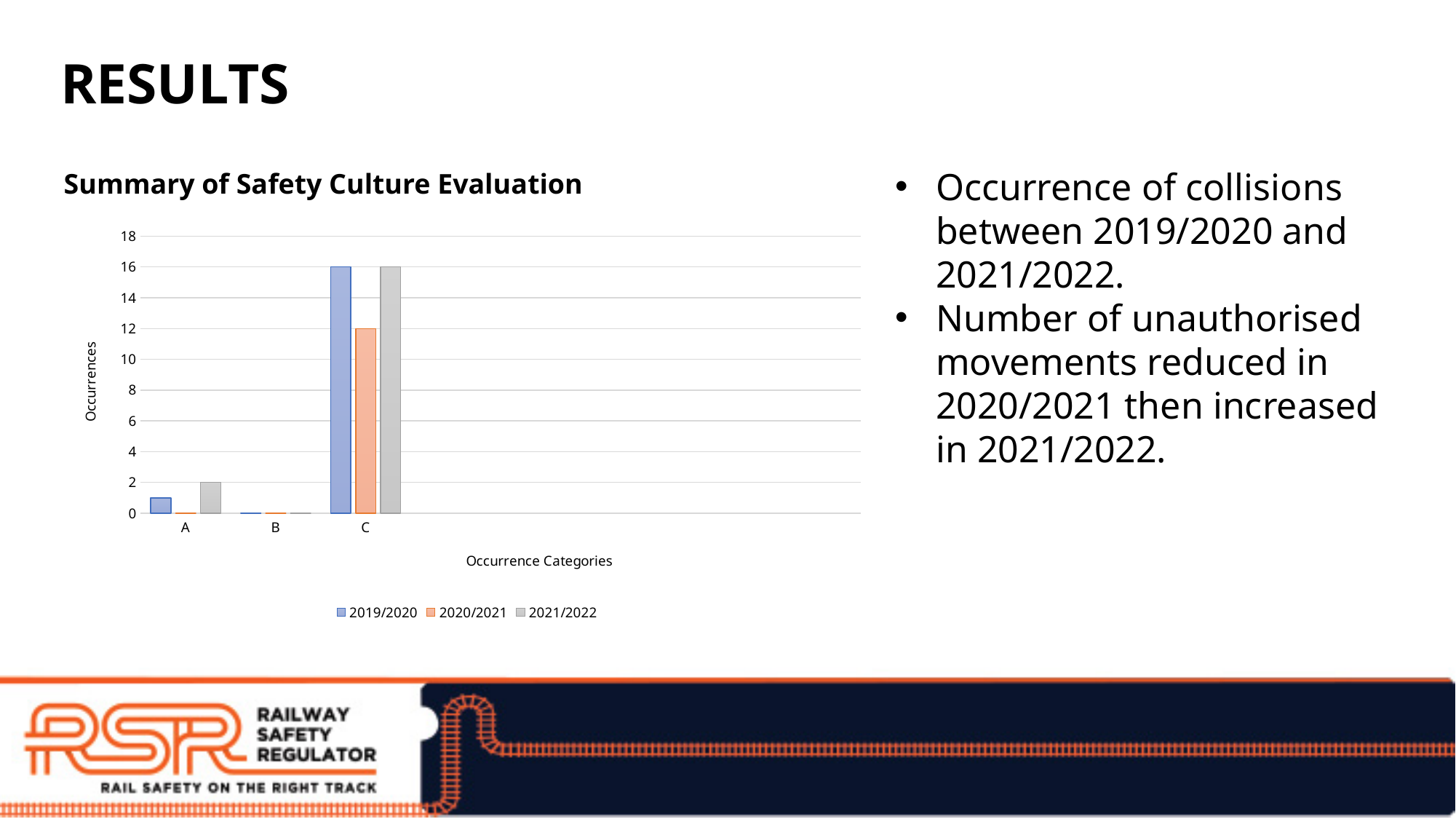
What type of chart is shown on the slide? Bar chart How many series does the legend list? 3 What is the number of occurrences for category C in 2019/2020? 16 What is the number of occurrences for category C in 2021/2022? 16 For category C, which series has more occurrences: 2019/2020 or 2020/2021? 2019/2020 What is the title of the chart? Summary of Safety Culture Evaluation What is the number of occurrences for category C in 2020/2021? 12 What is the difference between the 2019/2020 and 2020/2021 occurrences for category C? 4 Is the value for category A in 2019/2020 greater or less than 2? less Which occurrence category has the highest number of occurrences? C What is the number of occurrences for category A in 2021/2022? 2 How many occurrence categories are shown on the x axis? 3